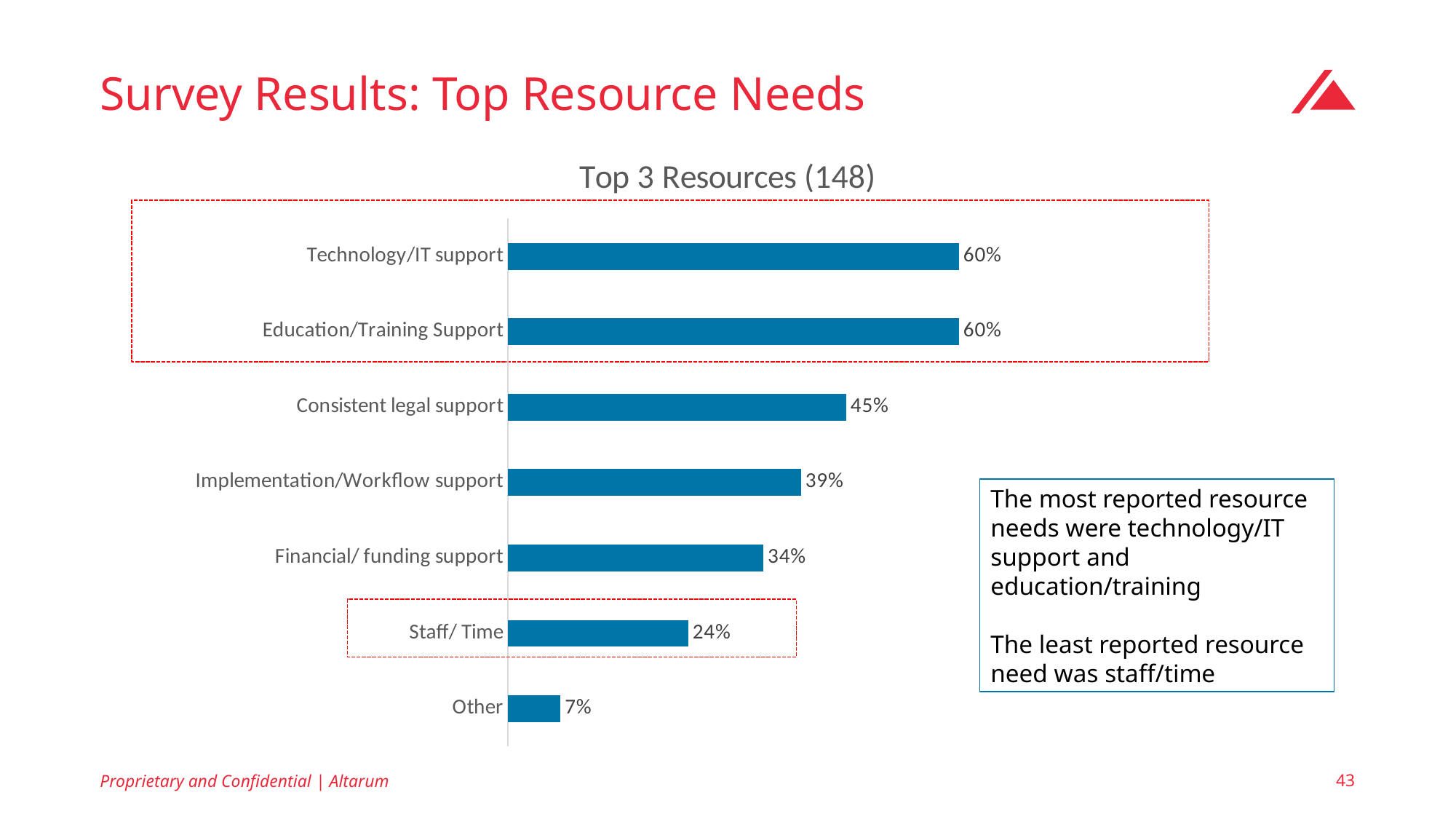
What is the value for Staff/ Time? 24% What is the difference between Staff/ Time and Other? 17% What is the value for Financial/ funding support? 34% What is the value for Implementation/Workflow support? 39% Which is larger, Implementation/Workflow support or Financial/ funding support? Implementation/Workflow support What is the value for Technology/IT support? 60% What is the value for Consistent legal support? 45% What kind of chart is this? Bar chart What is the difference between Technology/IT support and Consistent legal support? 15% How many categories are shown in the chart? 7 Which category has the lowest value? Other What is the title of the chart? Top 3 Resources (148)